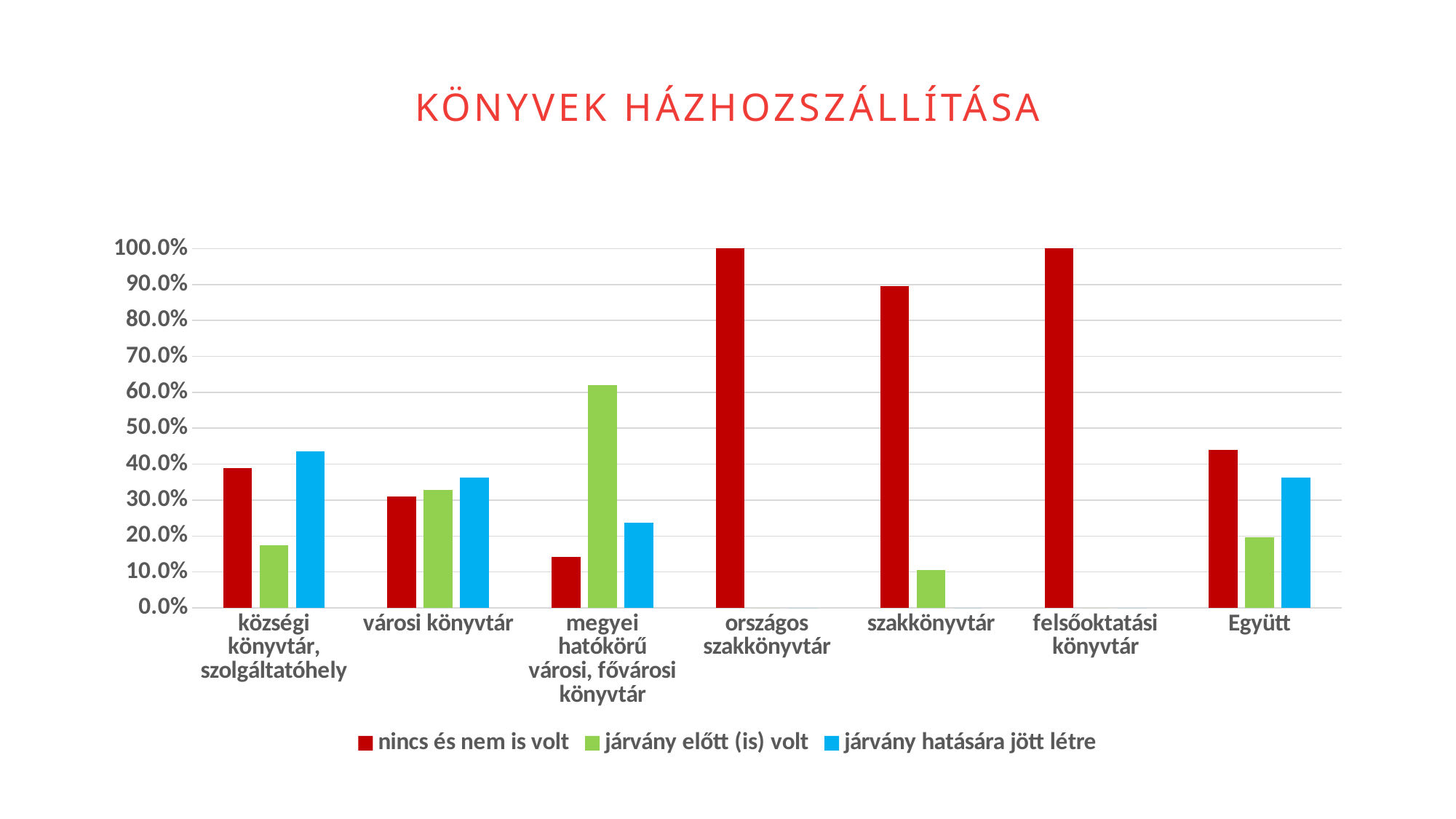
Is the value of 'járvány előtt (is) volt' for 'megyei hatókörű városi, fővárosi könyvtár' greater or less than 50.0%? greater Is the value of 'járvány előtt (is) volt' for 'községi könyvtár, szolgáltatóhely' greater or less than 20.0%? less Which category has the highest value for 'járvány előtt (is) volt'? megyei hatókörű városi, fővárosi könyvtár What is the value of 'nincs és nem is volt' for 'felsőoktatási könyvtár'? 100.0% How many categories are shown on the x axis? 7 Which category has the lowest value for 'nincs és nem is volt'? megyei hatókörű városi, fővárosi könyvtár What is the value of 'nincs és nem is volt' for 'országos szakkönyvtár'? 100.0% What kind of chart is shown on the slide? bar chart For 'megyei hatókörű városi, fővárosi könyvtár', which is larger: 'járvány előtt (is) volt' or 'járvány hatására jött létre'? járvány előtt (is) volt What is the title of the chart? KÖNYVEK HÁZHOZSZÁLLÍTÁSA How many series does the legend list? 3 For 'községi könyvtár, szolgáltatóhely', which is larger: 'nincs és nem is volt' or 'járvány hatására jött létre'? járvány hatására jött létre